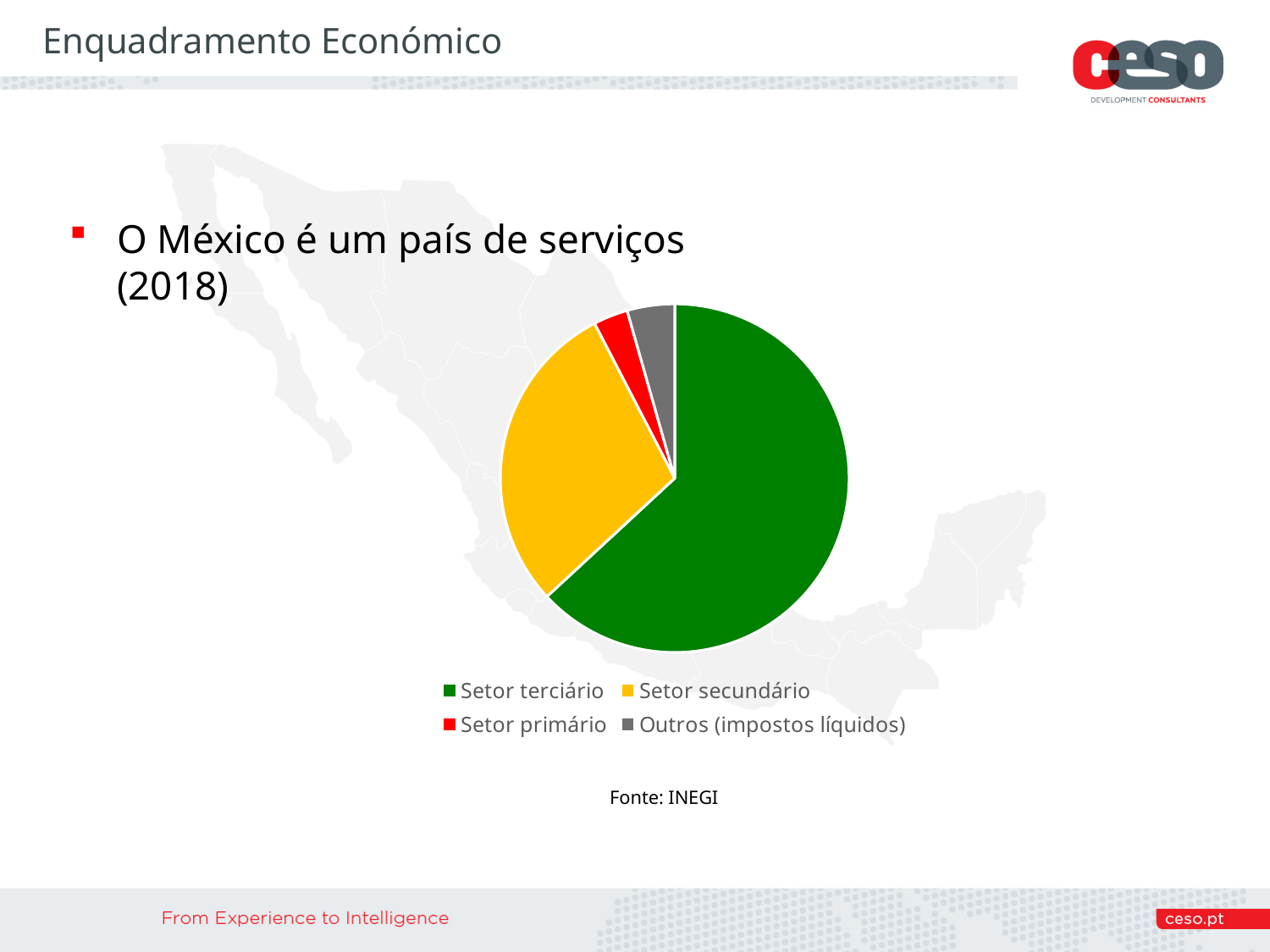
What is the source cited below the pie chart? INEGI Which slice is larger, Setor secundário or Setor primário? Setor secundário How many slices does the pie chart have? 4 Which slice is larger, Setor terciário or Setor secundário? Setor terciário Which sector has the largest slice in the pie chart? Setor terciário How many entries does the legend of the pie chart list? 4 What kind of chart is shown on the slide? Pie chart Which slice is larger, Setor terciário or Outros (impostos líquidos)? Setor terciário Which colour represents Setor terciário in the pie chart? Green